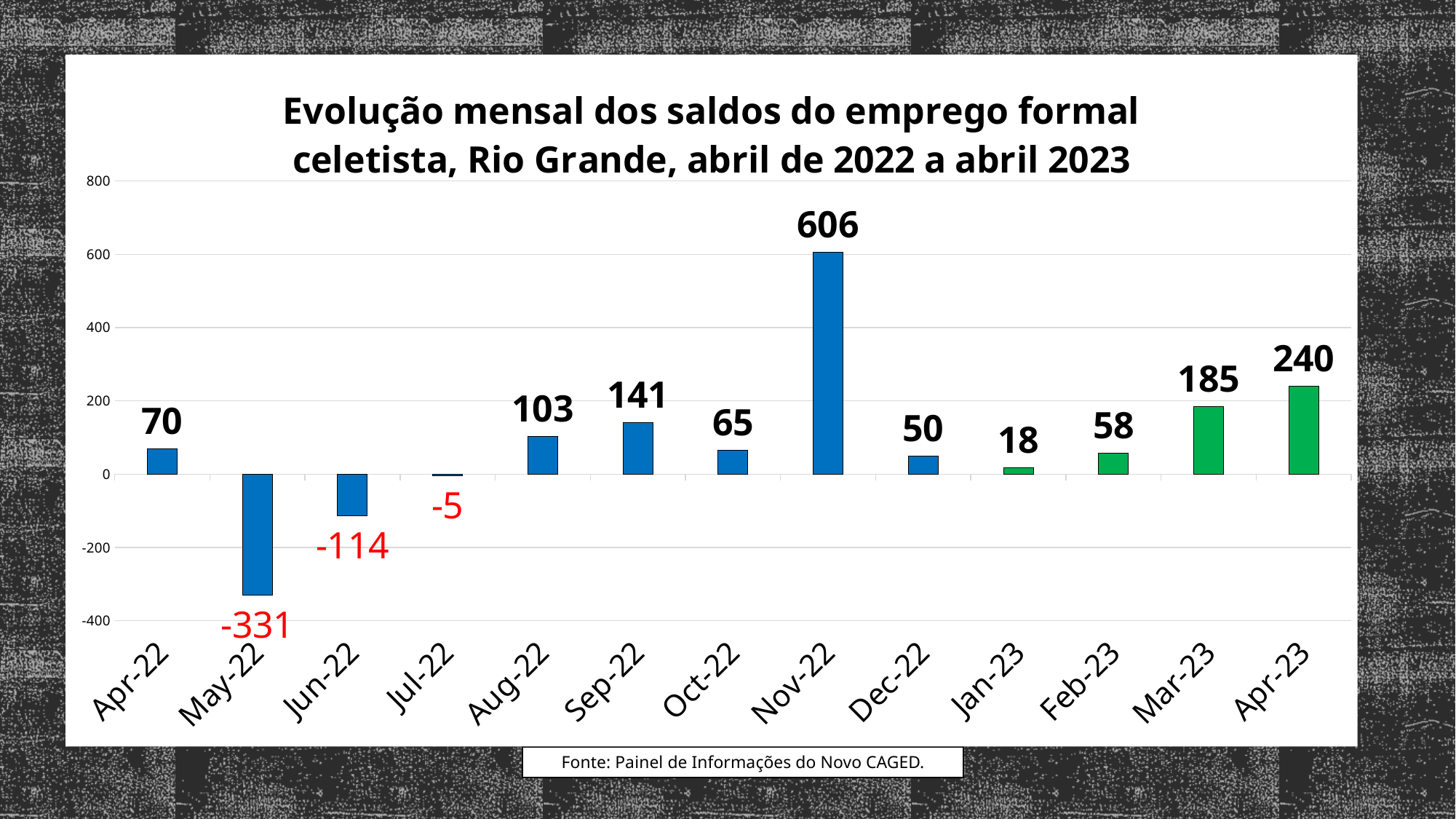
What is the difference between the values for Apr-23 and Mar-23? 55 What kind of chart is shown? bar chart Which month has the highest value? Nov-22 Is the value for Nov-22 greater or less than 400? greater What is the value for Apr-23? 240 What is the value for May-22? -331 How many months have a negative value? 3 What is the value for Nov-22? 606 What is the source cited below the chart? Painel de Informações do Novo CAGED Which is larger, the value for Aug-22 or the value for Sep-22? Sep-22 How many months are shown on the x axis? 13 Which month has the lowest value? May-22